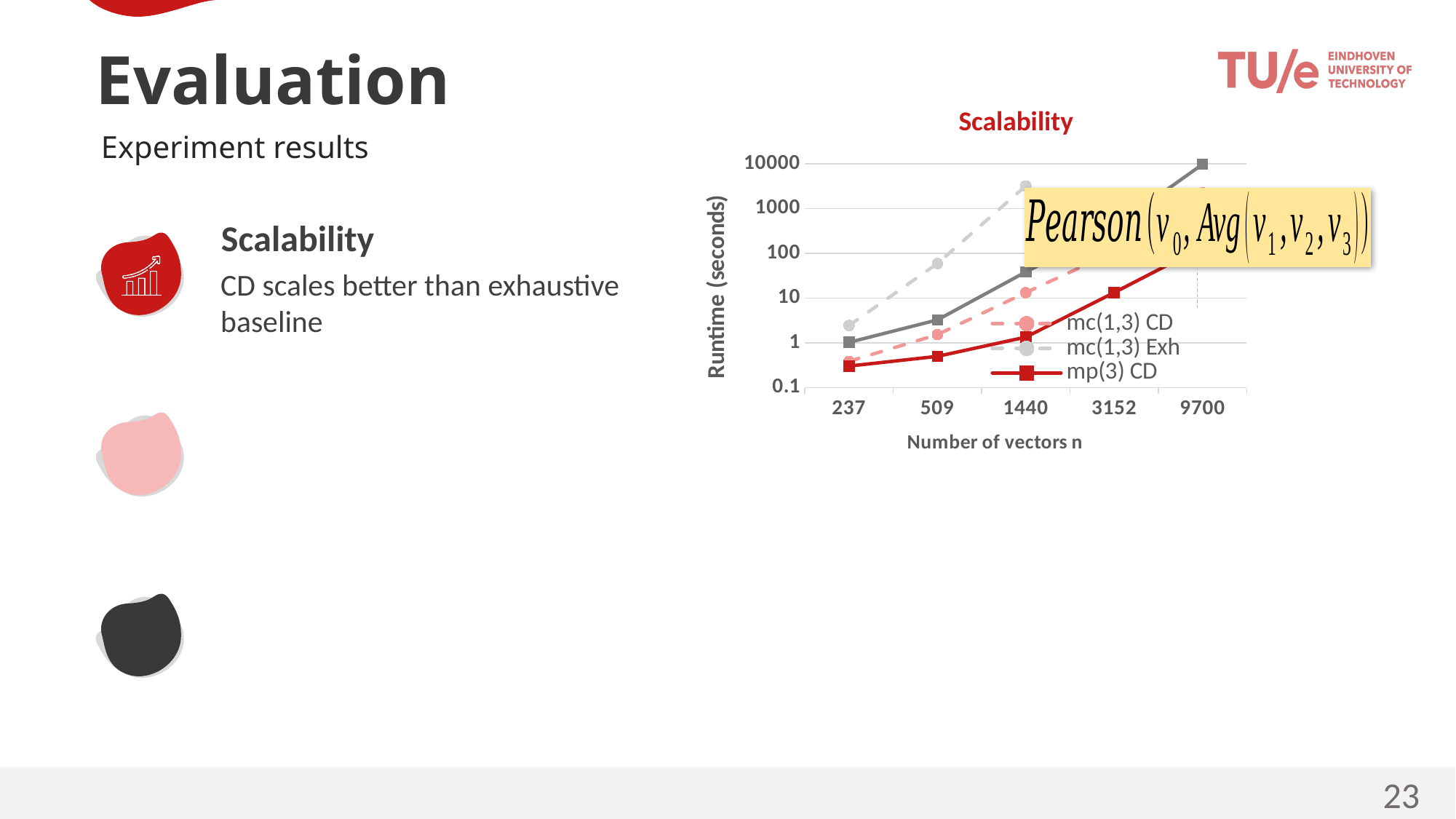
What is the title of the chart? Scalability Is the runtime for mc(1,3) Exh at n = 509 greater or less than 10 seconds? greater How many values of n are plotted along the x axis? 5 At n = 1440, which has the higher runtime: mc(1,3) Exh or mc(1,3) CD? mc(1,3) Exh What is the label of the x axis of the chart? Number of vectors n Is the runtime for mc(1,3) CD at n = 237 greater or less than 1 second? less Is the runtime for mp(3) CD at n = 237 greater or less than 1 second? less Does the runtime of mc(1,3) Exh rise or fall as the number of vectors n increases? rise Does the runtime of mp(3) CD rise or fall as the number of vectors n increases? rise At n = 237, which has the higher runtime: mc(1,3) Exh or mp(3) CD? mc(1,3) Exh What kind of chart is shown on the slide? line chart